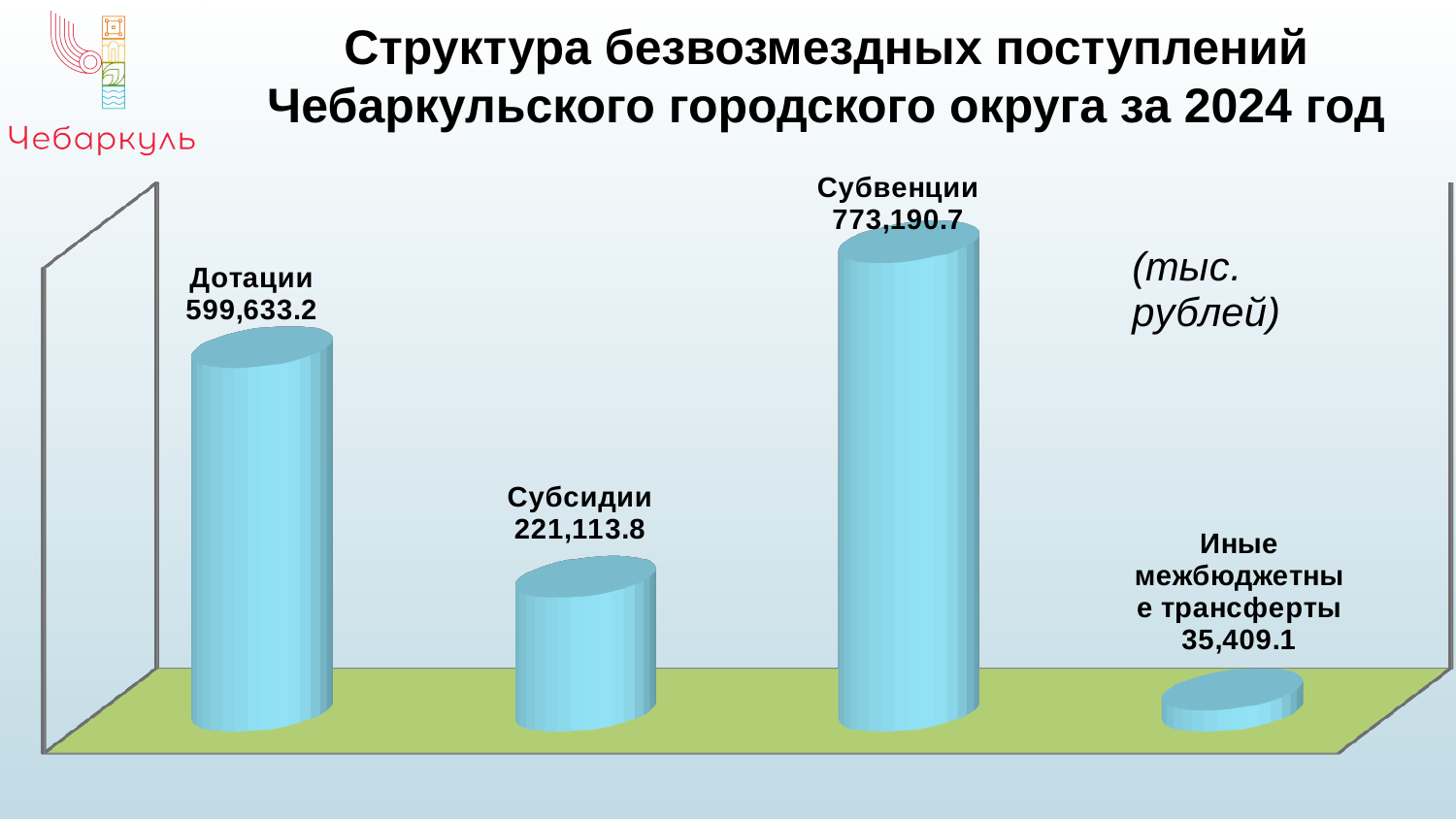
In what units are the values on the chart given? тыс. рублей Which is larger, Субсидии or Дотации? Дотации What is the value for Субвенции? 773,190.7 What is the value for Субсидии? 221,113.8 What is the value for Иные межбюджетные трансферты? 35,409.1 What type of chart is shown on the slide? Bar chart What is the difference between Субвенции and Дотации? 173,557.5 Which category has the highest value? Субвенции What is the value for Дотации? 599,633.2 Which category has the lowest value? Иные межбюджетные трансферты How many categories are shown in the chart? 4 What is the difference between Дотации and Субсидии? 378,519.4